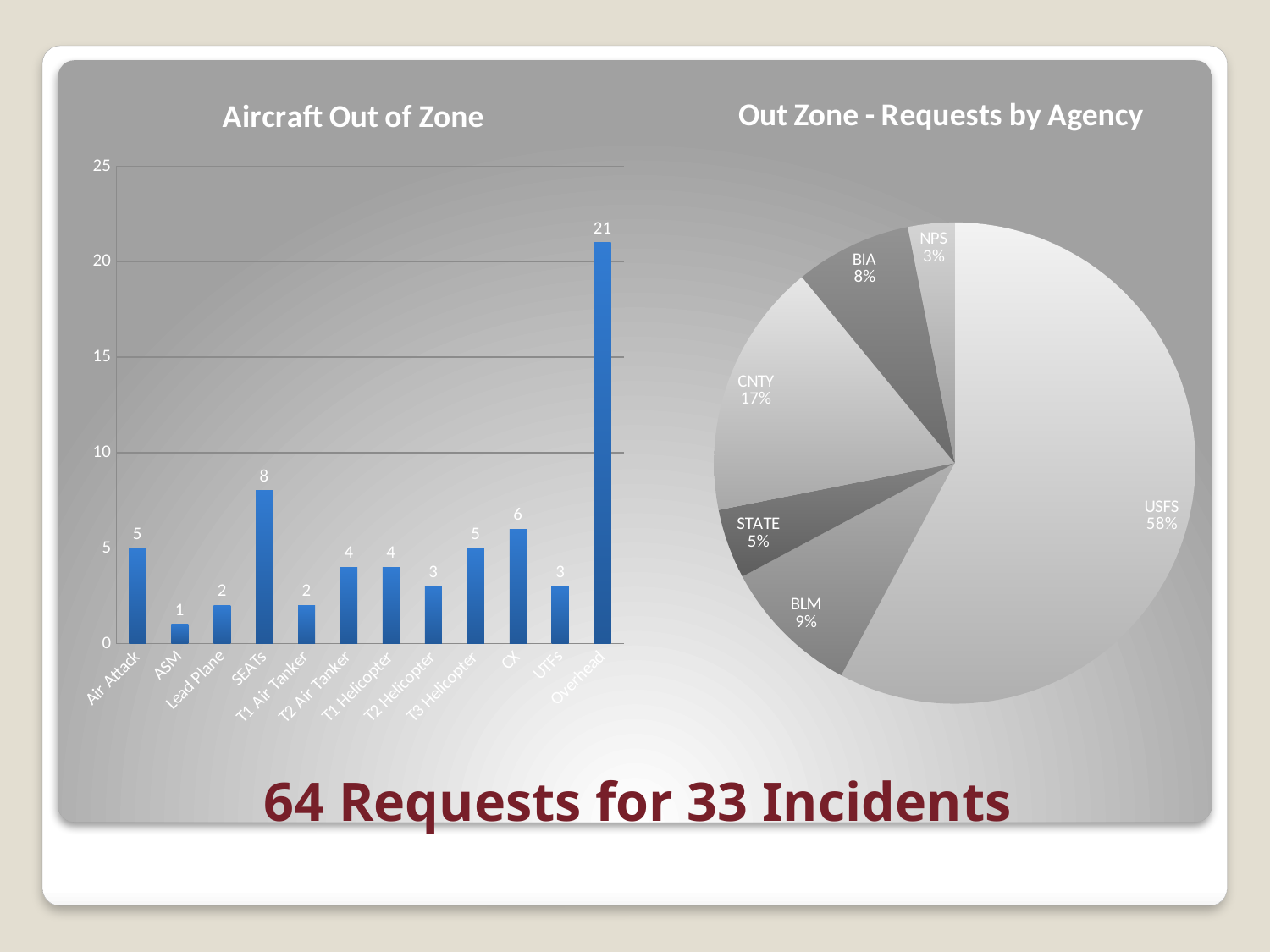
In the "Out Zone - Requests by Agency" pie chart, which agency has the smallest share? NPS How many slices are in the "Out Zone - Requests by Agency" pie chart? 6 In the "Aircraft Out of Zone" bar chart, which category has the highest value? Overhead In the "Aircraft Out of Zone" bar chart, what is the value for SEATs? 8 In the "Out Zone - Requests by Agency" pie chart, what share does USFS have? 58% In the "Aircraft Out of Zone" bar chart, what is the difference between the values for Overhead and SEATs? 13 In the "Aircraft Out of Zone" bar chart, which is larger, the value for CX or the value for Air Attack? CX In the "Out Zone - Requests by Agency" pie chart, what share does CNTY have? 17% In the "Aircraft Out of Zone" bar chart, which category has the lowest value? ASM How many categories are shown in the "Aircraft Out of Zone" bar chart? 12 In the "Aircraft Out of Zone" bar chart, what is the value for T2 Helicopter? 3 What kind of chart is "Aircraft Out of Zone"? Bar chart